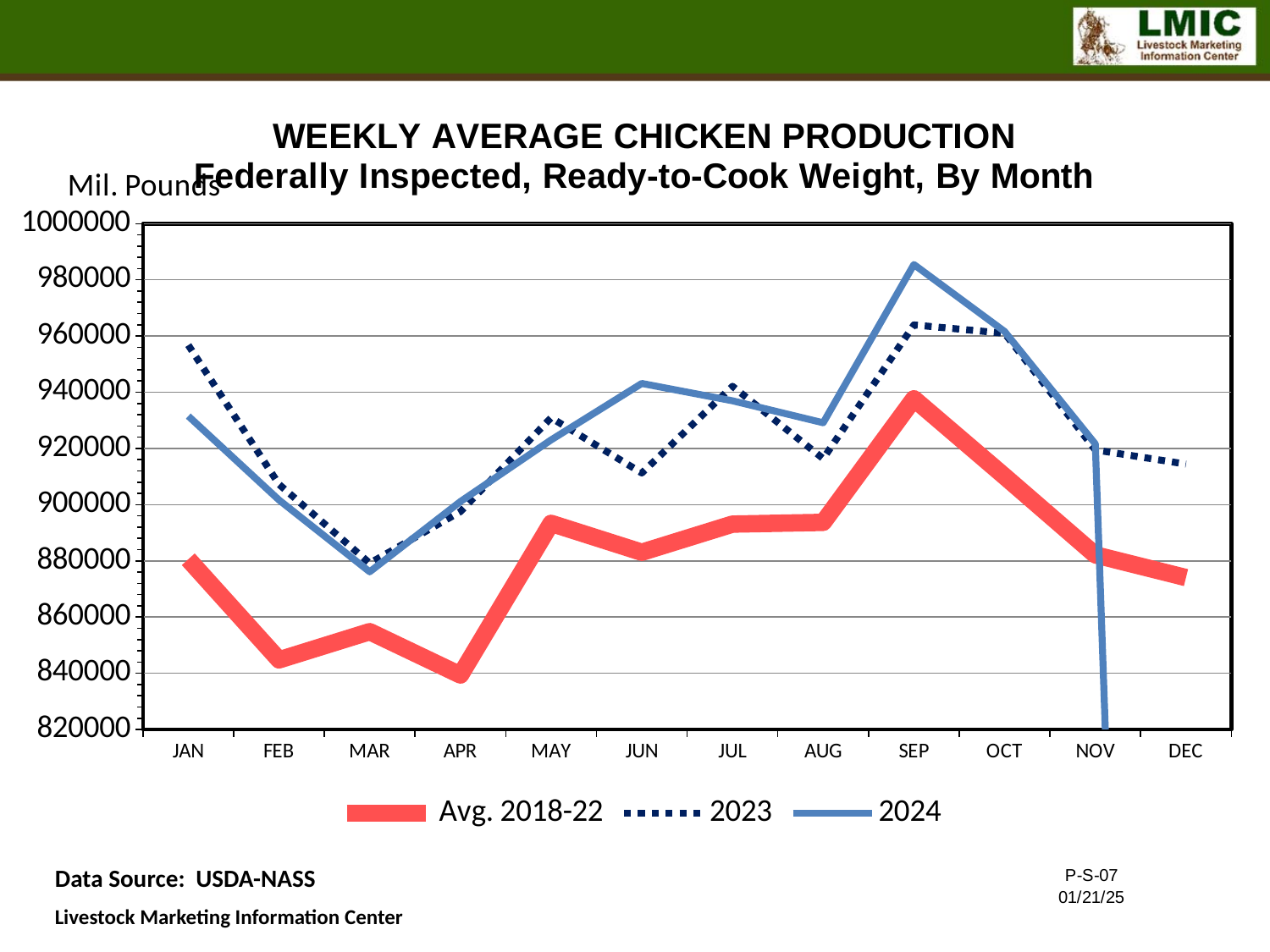
Is the 2023 value for JAN greater or less than 940000? greater Is the 2024 value for MAR greater or less than 900000? less What kind of chart is shown on the slide? line chart In JAN, which series is higher, 2023 or 2024? 2023 How many series does the legend list? 3 What unit label is shown above the y axis? Mil. Pounds In which month does the 2024 series reach its highest value? SEP In which month is the Avg. 2018-22 series at its lowest? APR Is the 2024 value for SEP greater or less than 960000? greater How many months are shown along the x axis? 12 Does the Avg. 2018-22 series rise or fall from SEP to DEC? fall